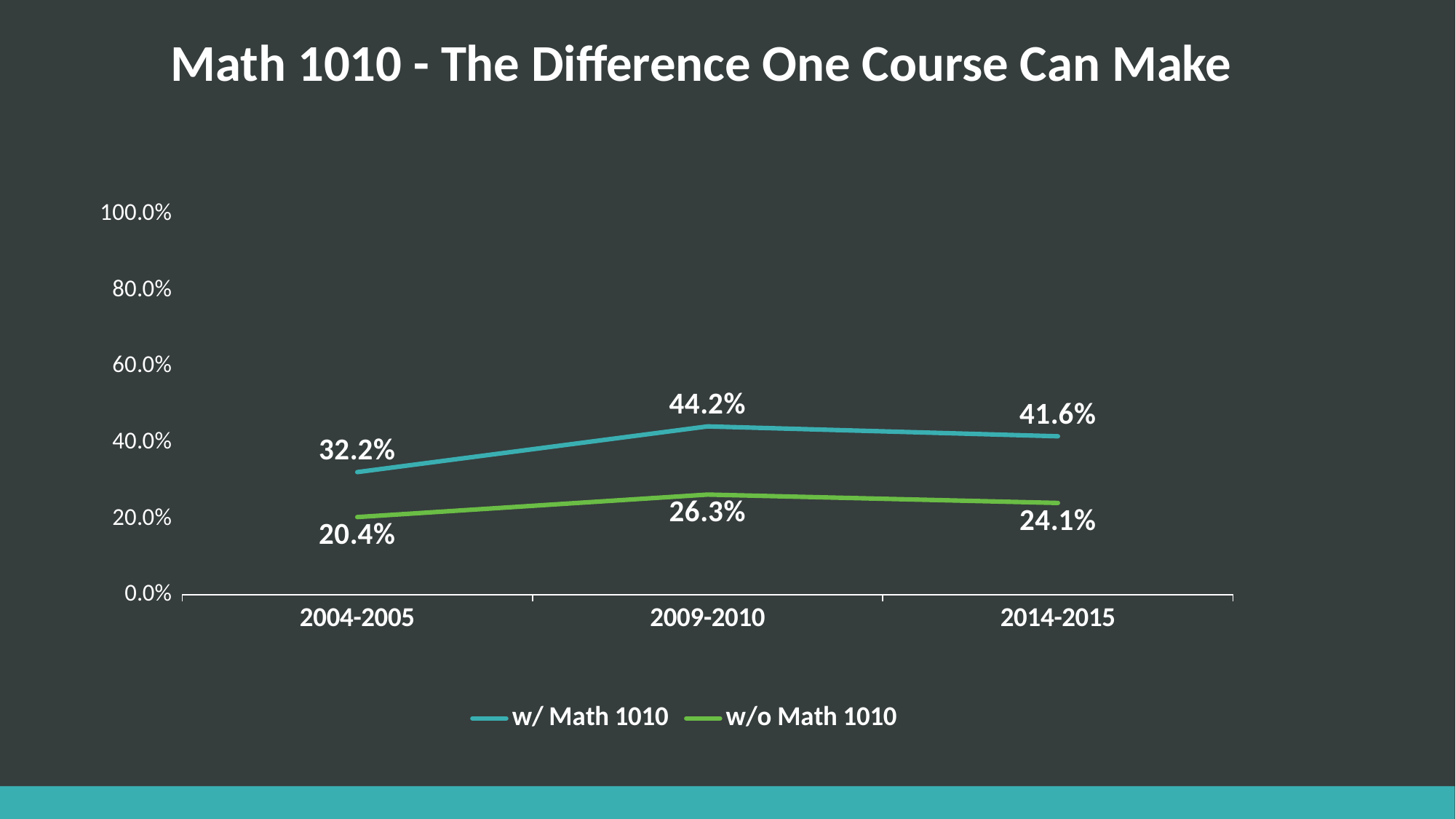
What is the value for w/o Math 1010 in 2004-2005? 20.4% Which series has the larger value in 2014-2015, w/ Math 1010 or w/o Math 1010? w/ Math 1010 What is the title of the chart? Math 1010 - The Difference One Course Can Make How many periods are shown on the x axis? 3 What is the value for w/ Math 1010 in 2014-2015? 41.6% What kind of chart is shown on the slide? line chart Is the value for w/o Math 1010 in 2014-2015 greater or less than 40.0%? less In which period is the w/o Math 1010 series lowest? 2004-2005 How many series does the legend list? 2 In which period is the w/ Math 1010 series highest? 2009-2010 What is the value for w/ Math 1010 in 2009-2010? 44.2% What is the difference between w/ Math 1010 and w/o Math 1010 in 2009-2010? 17.9%